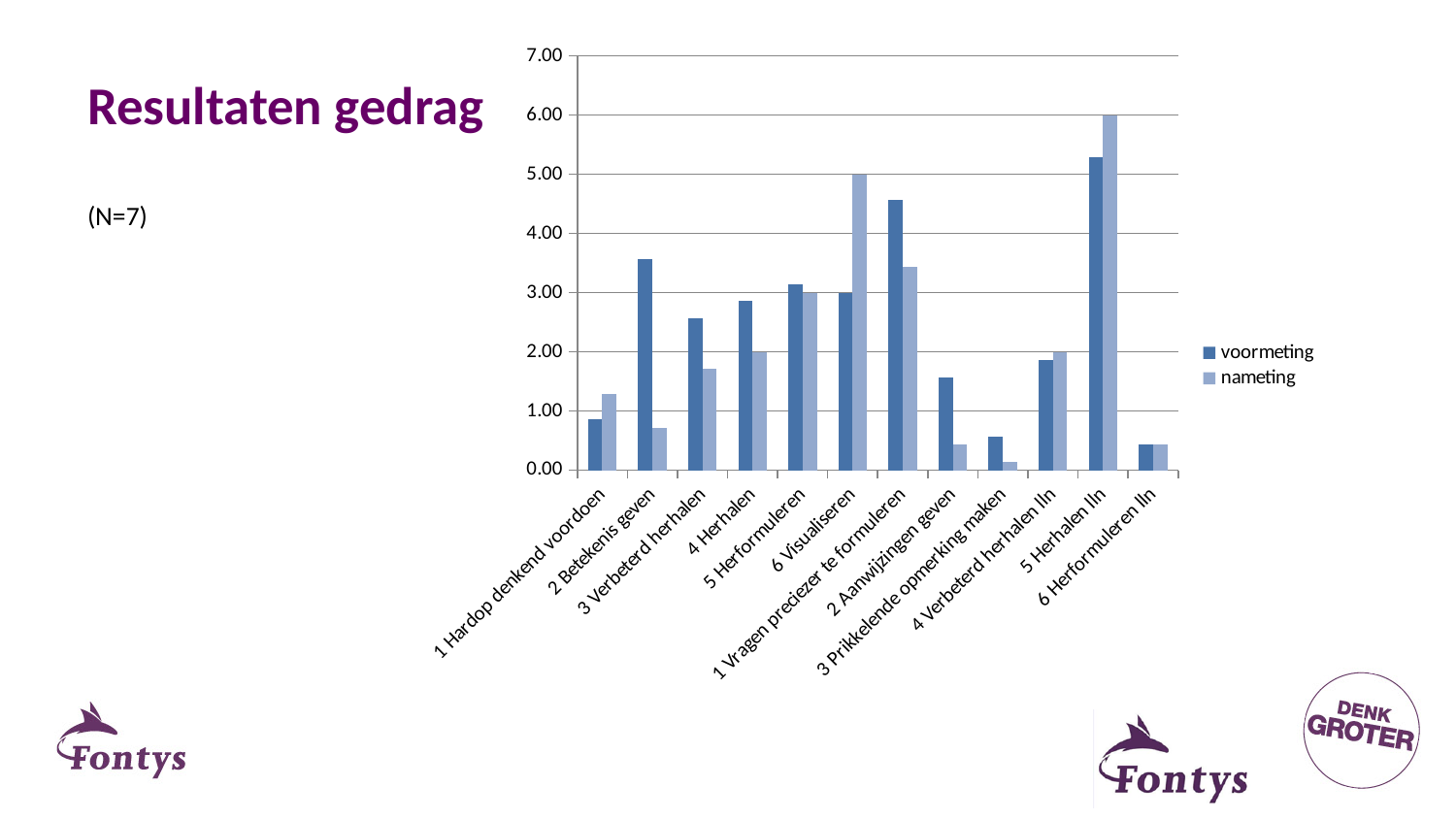
How many series does the legend list? 2 Which category has the highest nameting value? 5 Herhalen lln What is the nameting value for 6 Visualiseren? 5.00 For 1 Vragen preciezer te formuleren, which is larger: voormeting or nameting? voormeting Which category has the lowest nameting value? 3 Prikkelende opmerking maken What is the nameting value for 5 Herhalen lln? 6.00 How many categories are shown on the x axis? 12 What kind of chart is shown on the slide? bar chart Is the voormeting value for 2 Betekenis geven greater or less than 3.00? greater What is the title of the slide containing the chart? Resultaten gedrag Which category has the highest voormeting value? 5 Herhalen lln Is the voormeting value for 1 Hardop denkend voordoen greater or less than 1.00? less